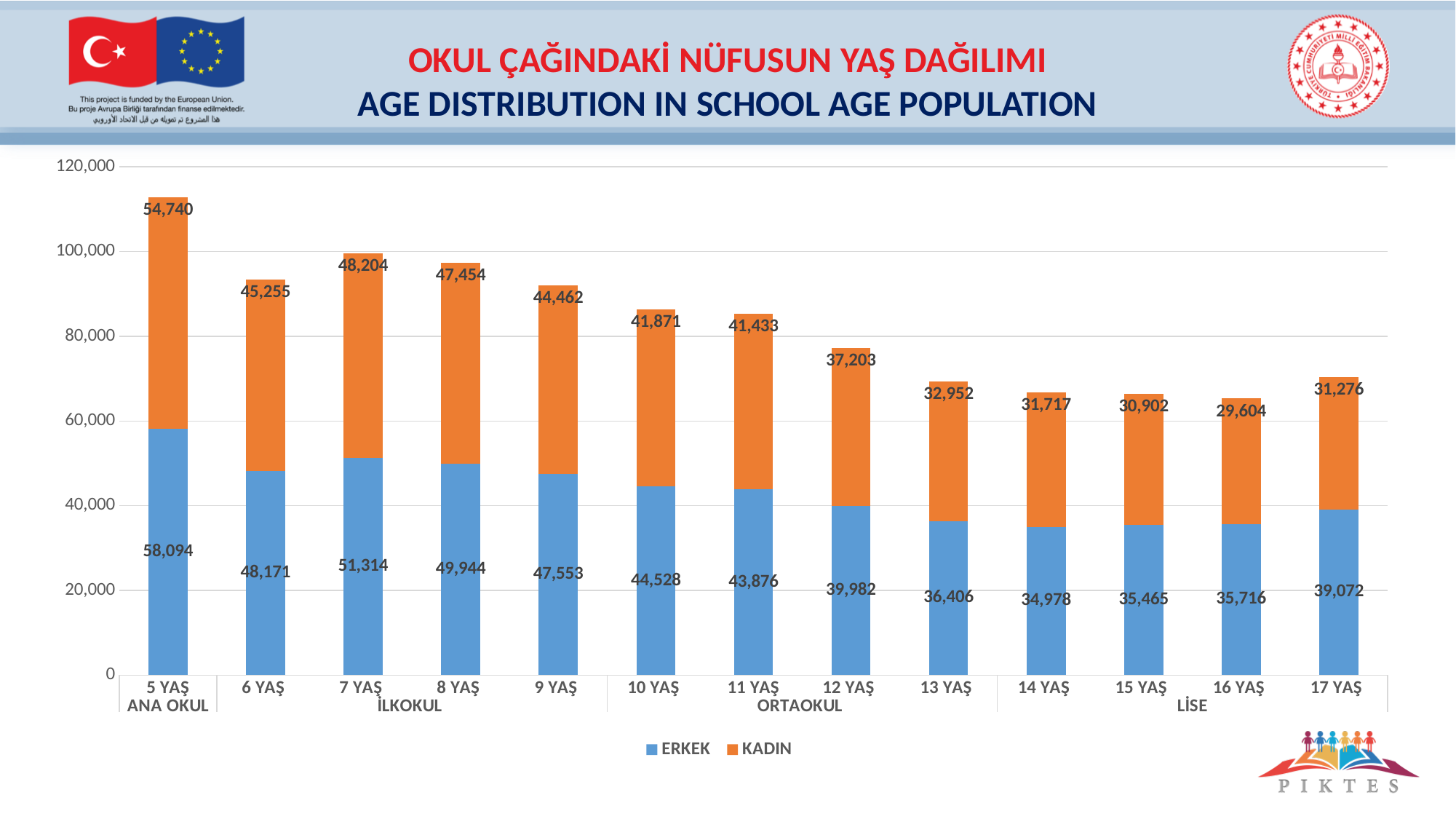
What is the total of the stacked bar for 10 YAŞ? 86,399 What is the difference between the ERKEK and KADIN values for 13 YAŞ? 3,454 What is the KADIN value for 12 YAŞ? 37,203 Which age category has the highest KADIN value? 5 YAŞ What is the ERKEK value for 17 YAŞ? 39,072 How many age categories are shown on the x axis? 13 Which is larger, the ERKEK value for 7 YAŞ or the ERKEK value for 8 YAŞ? 7 YAŞ Which colour represents the KADIN series? Orange Which age category has the lowest KADIN value? 16 YAŞ What is the ERKEK value for 5 YAŞ? 58,094 What kind of chart is shown on the slide? Stacked bar chart How many series does the legend list? 2